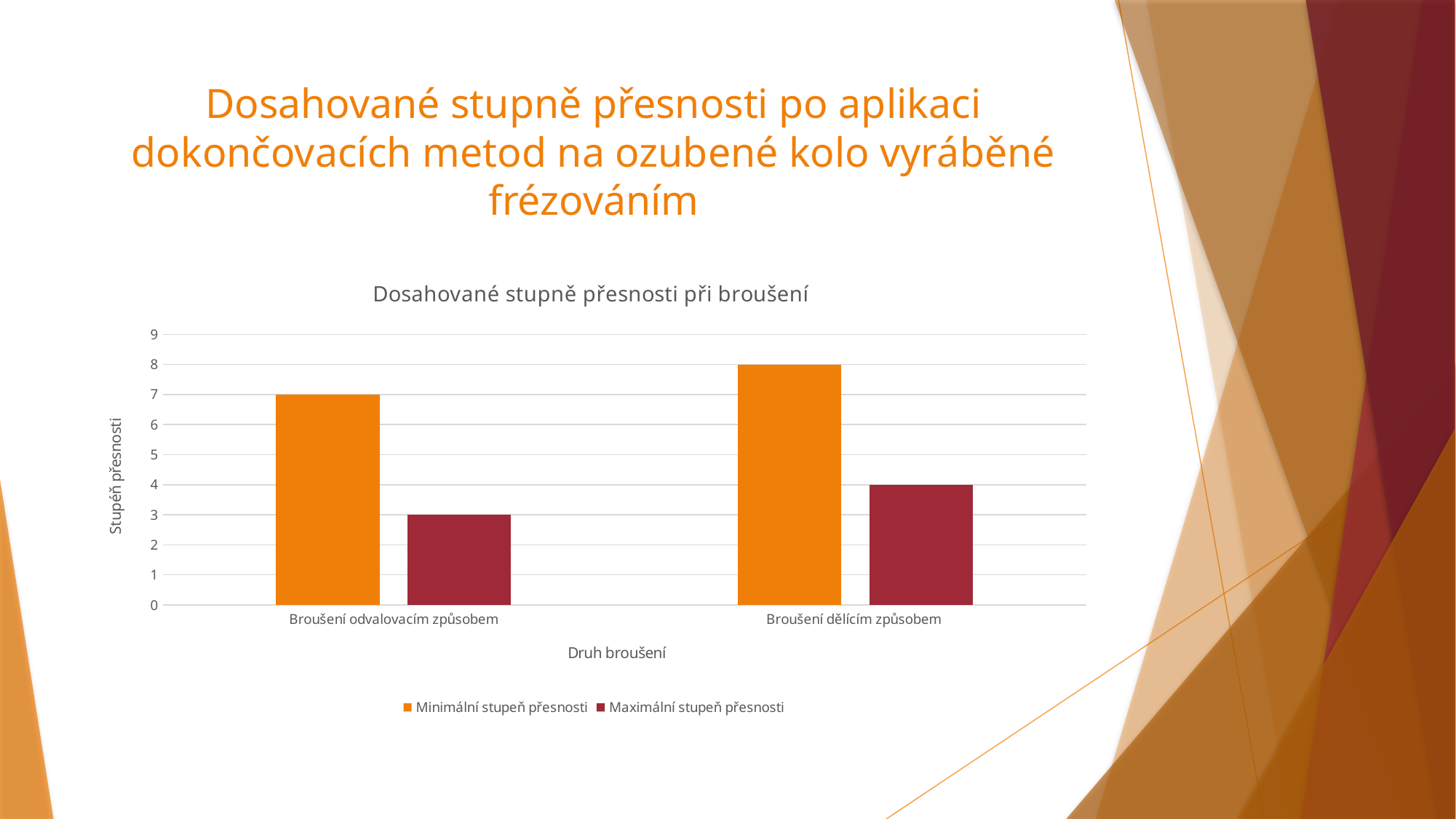
What is the value of Maximální stupeň přesnosti for Broušení dělícím způsobem? 4 Which category has the lowest Maximální stupeň přesnosti value? Broušení odvalovacím způsobem What is the value of Minimální stupeň přesnosti for Broušení odvalovacím způsobem? 7 What is the title of the chart? Dosahované stupně přesnosti při broušení What kind of chart is shown on the slide? bar chart What is the value of Minimální stupeň přesnosti for Broušení dělícím způsobem? 8 Which category has the highest Minimální stupeň přesnosti value? Broušení dělícím způsobem Which is larger: the Minimální stupeň přesnosti value for Broušení odvalovacím způsobem or for Broušení dělícím způsobem? Broušení dělícím způsobem What is the value of Maximální stupeň přesnosti for Broušení odvalovacím způsobem? 3 What is the difference between the Minimální stupeň přesnosti and Maximální stupeň přesnosti values for Broušení dělícím způsobem? 4 How many series does the legend list? 2 How many categories are shown on the x axis? 2